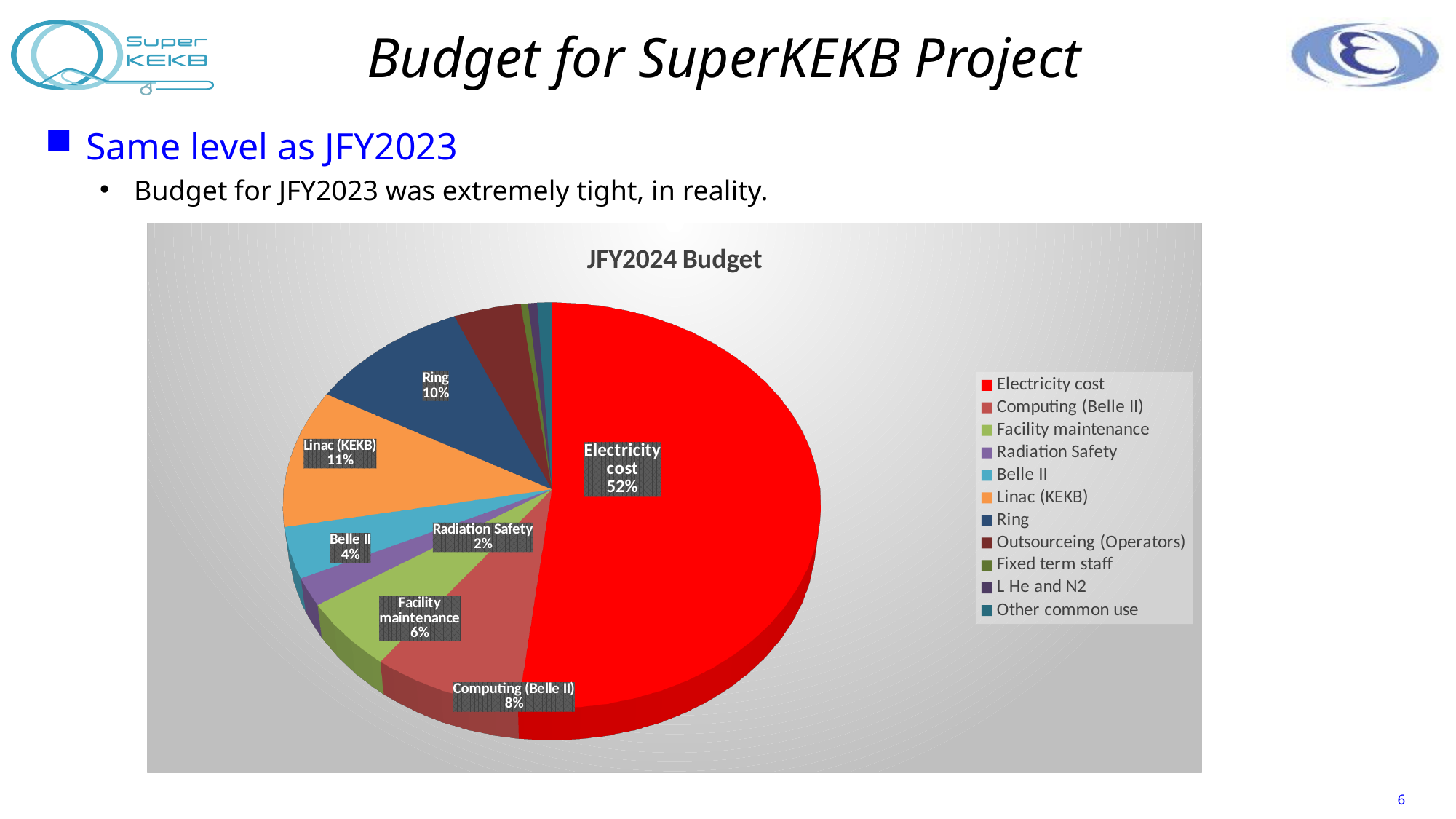
What share of the JFY2024 Budget is Facility maintenance? 6% What share of the JFY2024 Budget is Radiation Safety? 2% What is the difference in percentage points between the Electricity cost share and the Ring share? 42 How many categories does the legend list? 11 What is the title of the chart? JFY2024 Budget Which category has the largest share of the JFY2024 Budget? Electricity cost What share of the JFY2024 Budget is Ring? 10% What type of chart is shown on the slide? Pie chart Which is larger, the share for Linac (KEKB) or the share for Belle II? Linac (KEKB)